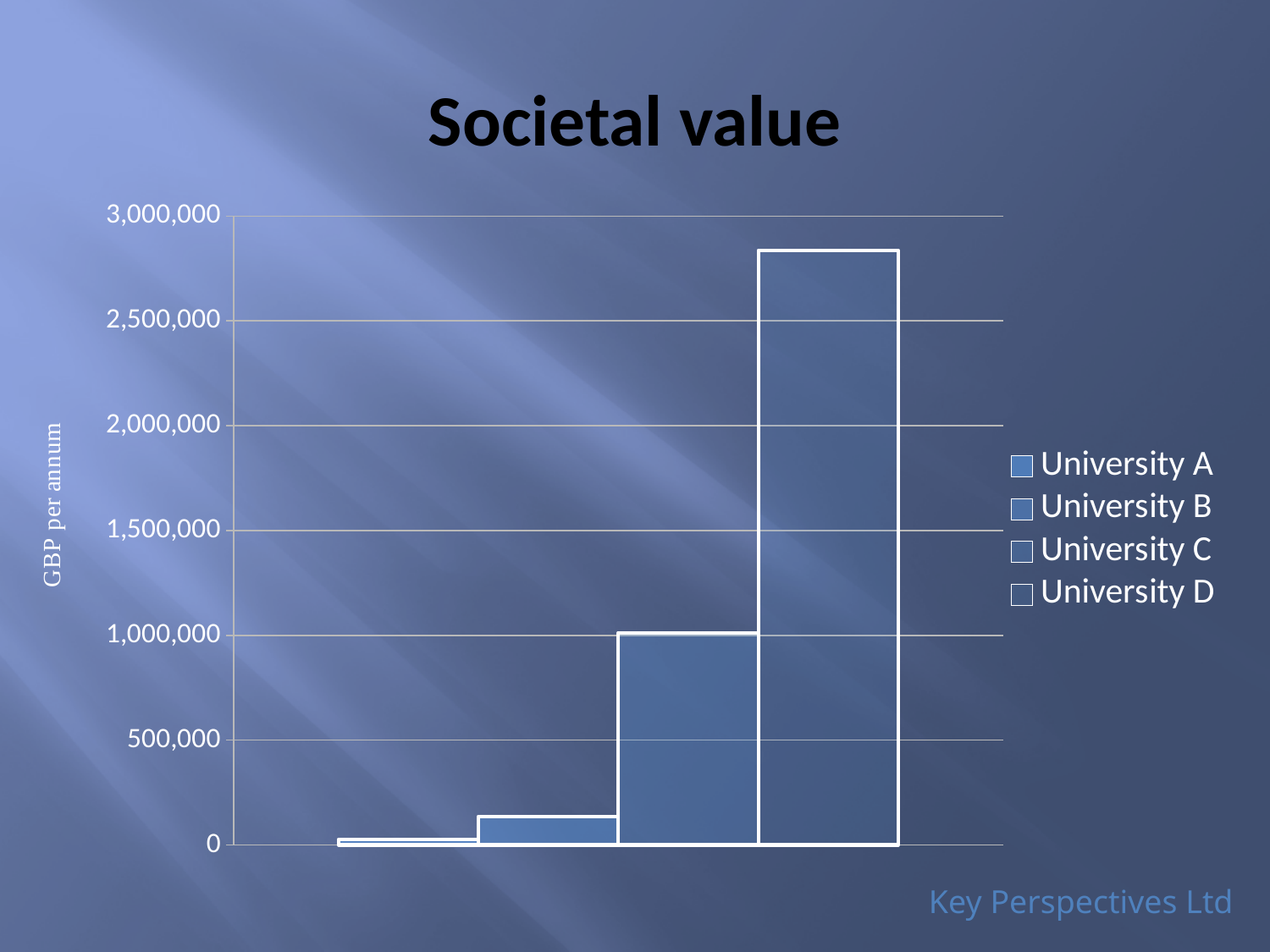
Which university has the highest societal value? University D Is the value for University C greater or less than 500,000? greater Do the bar values rise or fall from left to right across the chart? rise What is the label on the vertical axis of the chart? GBP per annum Is the value for University B greater or less than 500,000? less Which university has the lowest societal value? University A Is the value for University D greater or less than 2,500,000? greater Which is larger, the value for University C or University D? University D How many series does the legend list? 4 Which is larger, the value for University A or University B? University B What kind of chart is shown on the slide? bar chart